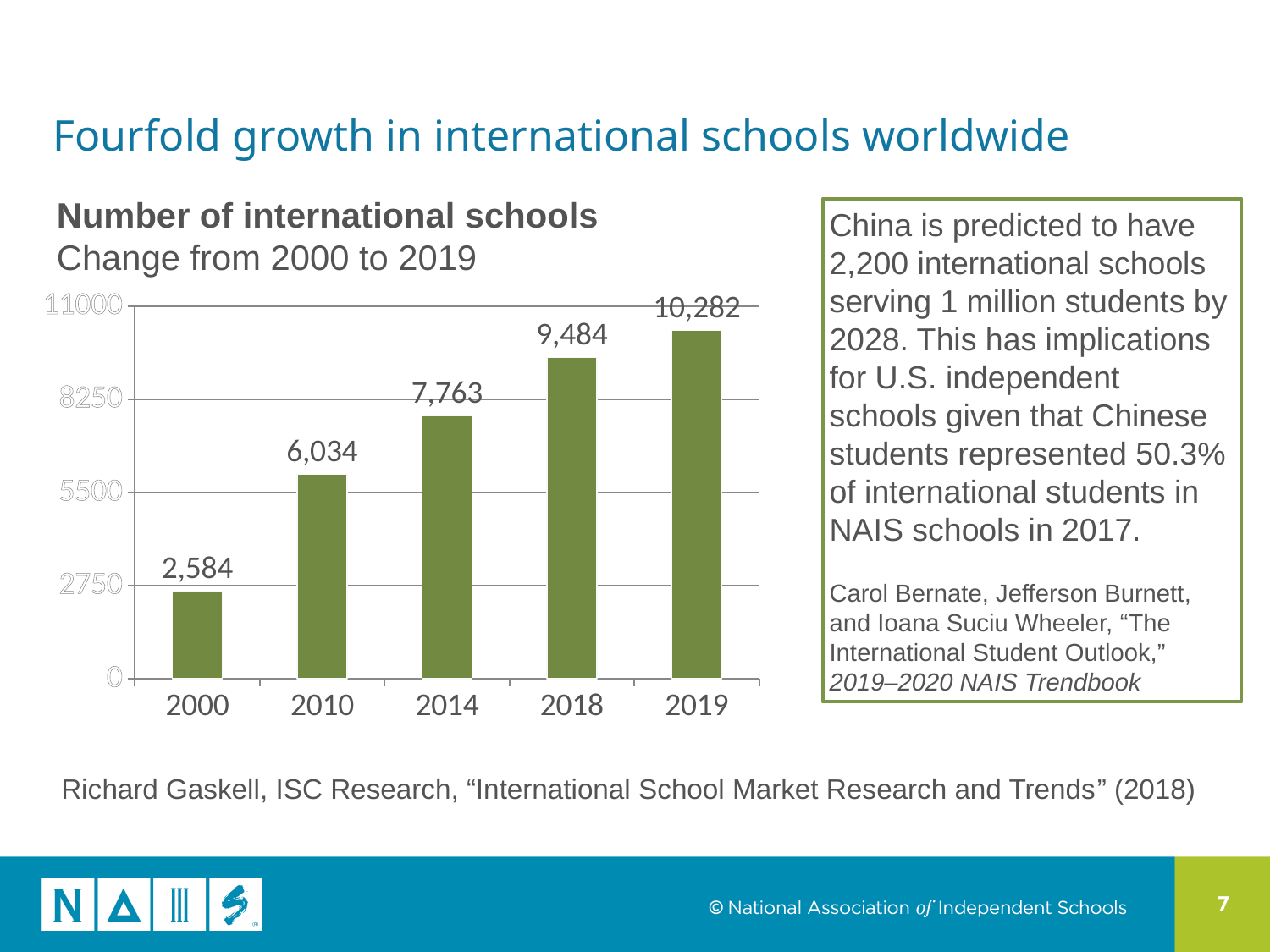
Which year has the lowest number of international schools? 2000 Which is larger, the number of international schools in 2010 or in 2014? 2014 What is the number of international schools in 2000? 2,584 Which year has the highest number of international schools? 2019 Is the value for 2010 greater or less than 5500? greater What is the number of international schools in 2019? 10,282 How many years are shown on the x axis of the chart? 5 What is the number of international schools in 2014? 7,763 Do the values rise or fall from 2000 to 2019? Rise What is the difference between the number of international schools in 2019 and in 2000? 7,698 What kind of chart is shown on the slide? Bar chart What is the difference between the number of international schools in 2018 and in 2014? 1,721